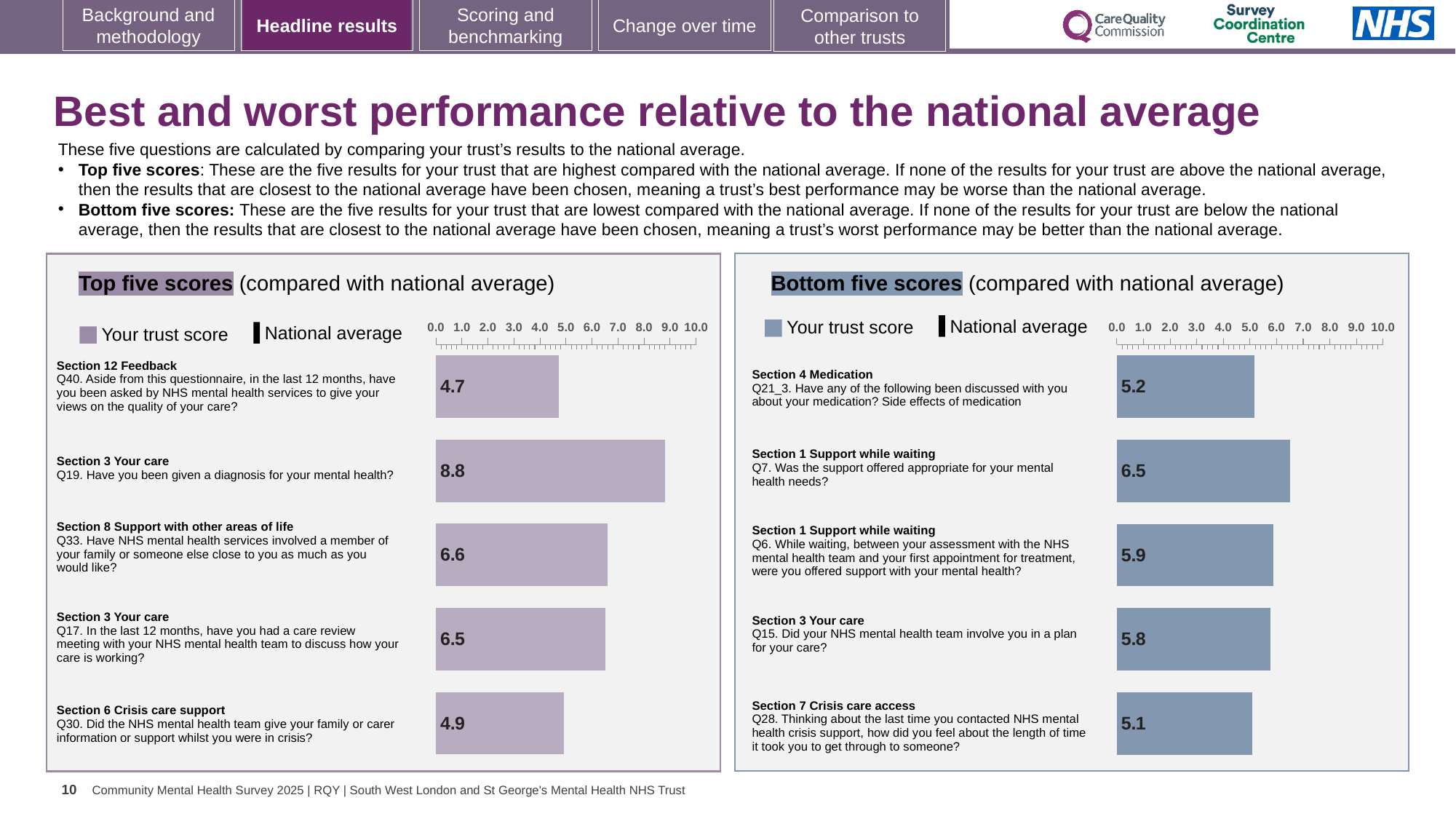
In the 'Bottom five scores' chart, what is the trust score for Q7 (Was the support offered appropriate for your mental health needs?)? 6.5 In the 'Top five scores' chart, what is the trust score for Q19 (Have you been given a diagnosis for your mental health?)? 8.8 In the 'Top five scores' chart, what is the difference between the trust scores for Q19 and Q40? 4.1 In the 'Bottom five scores' chart, what is the trust score for Q28 (how did you feel about the length of time it took you to get through to someone?)? 5.1 In the 'Bottom five scores' chart, which question has the lowest trust score? Q28 In the 'Bottom five scores' chart, which question has the highest trust score? Q7 In the 'Bottom five scores' chart, which has the larger trust score, Q21_3 or Q6? Q6 How many questions are shown in the 'Bottom five scores' chart? 5 In the 'Top five scores' chart, which question has the lowest trust score? Q40 In the 'Top five scores' chart, which question has the highest trust score? Q19 In the 'Top five scores' chart, what is the trust score for Q30 (Did the NHS mental health team give your family or carer information or support whilst you were in crisis?)? 4.9 What type of chart is the 'Top five scores' chart? Bar chart